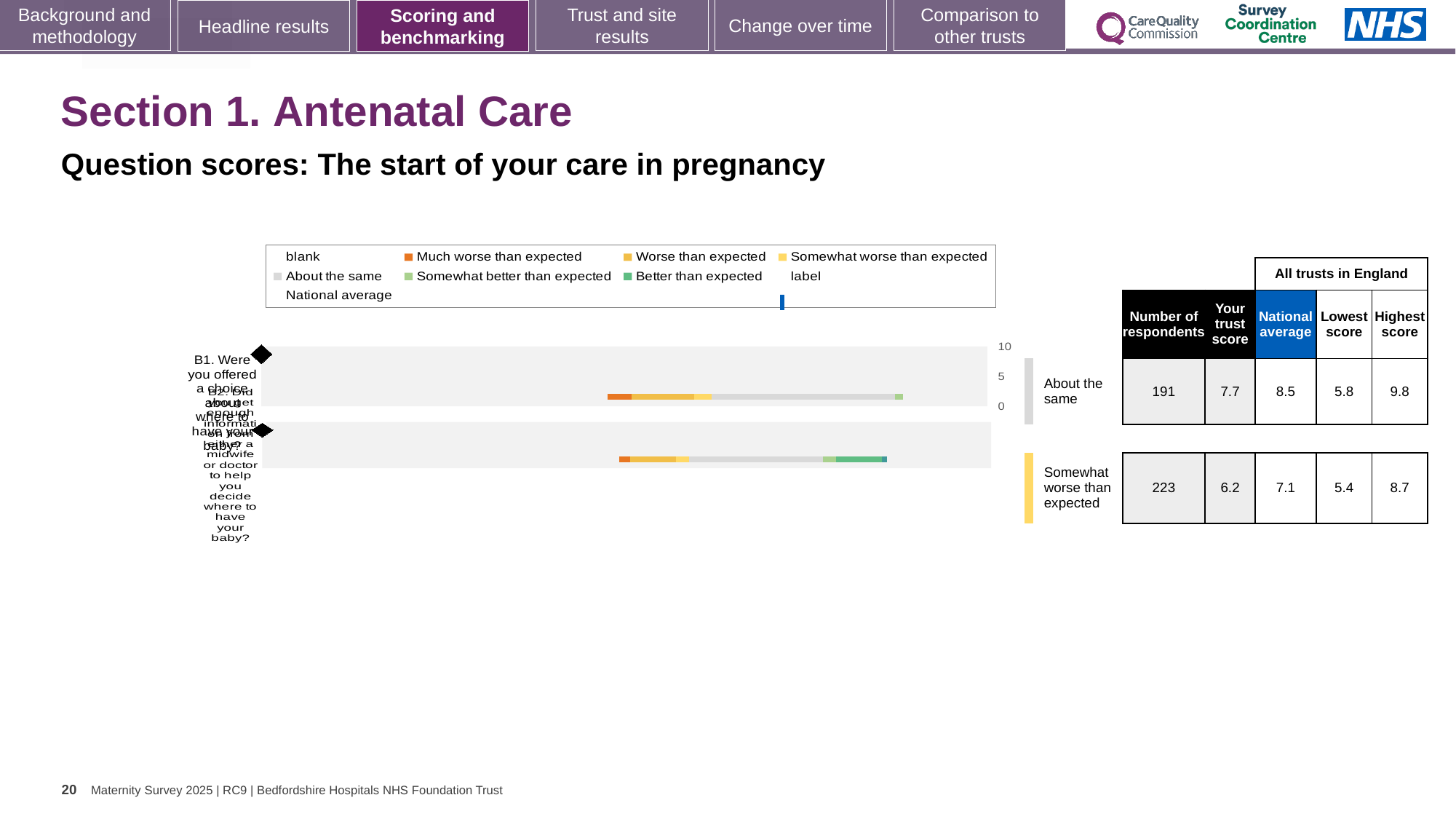
In the table beside the chart, what is the number of respondents for the row labelled 'About the same'? 191 In the table beside the chart, what is the lowest score for the row labelled 'About the same'? 5.8 What kind of chart is shown on the slide? bar chart In the table beside the chart, what is the difference in number of respondents between the 'Somewhat worse than expected' row and the 'About the same' row? 32 In the table beside the chart, what is the national average for the row labelled 'About the same'? 8.5 In the table beside the chart, for the row labelled 'About the same', which is larger: 'Your trust score' or the national average? National average In the table beside the chart, what is the difference between the national average and 'Your trust score' for the row labelled 'About the same'? 0.8 How many survey questions (bars) are plotted in the chart? 2 In the chart legend, what does the blue marker represent? National average In the table beside the chart, what is 'Your trust score' for the row labelled 'Somewhat worse than expected'? 6.2 In the chart legend, what colour represents 'Much worse than expected'? orange In the table beside the chart, what is the highest score for the row labelled 'Somewhat worse than expected'? 8.7